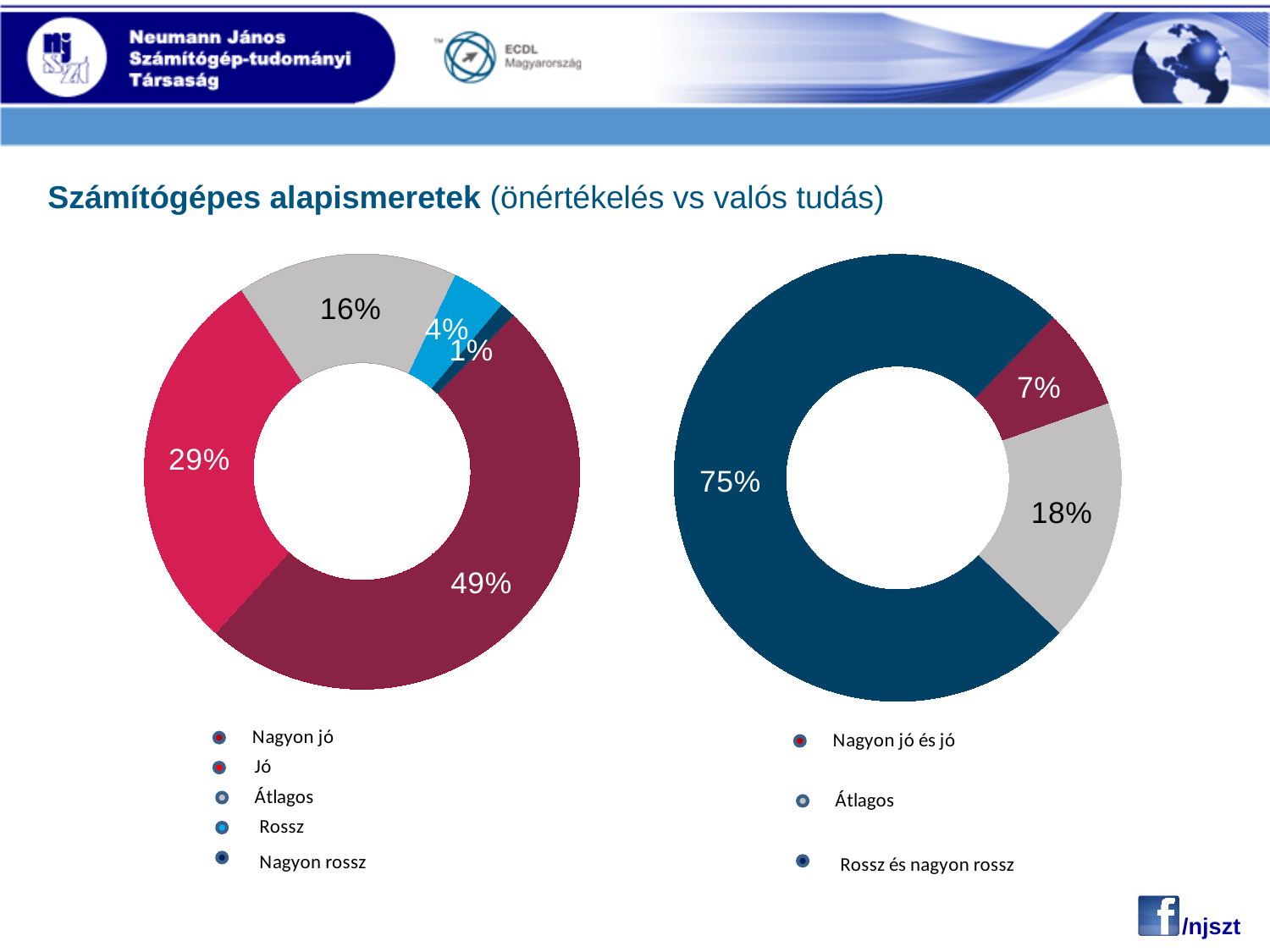
On the left chart, which category has the largest share? Nagyon jó On the right chart, what percentage is shown for Rossz és nagyon rossz? 75% What is the difference between the Jó and Nagyon jó shares on the left chart? 20% On the right chart, what percentage is shown for Átlagos? 18% On the right chart, which category has the smallest share? Nagyon jó és jó On the left chart, what percentage is shown for Nagyon jó? 49% On the left chart, which category has the smallest share? Nagyon rossz On the left chart, what percentage is shown for Rossz? 4% How many categories does the legend of the left chart list? 5 On the left chart, what percentage is shown for Jó? 29% What type of chart is used on the right side of the slide? Doughnut (pie) chart On the right chart, which is larger: Átlagos or Nagyon jó és jó? Átlagos